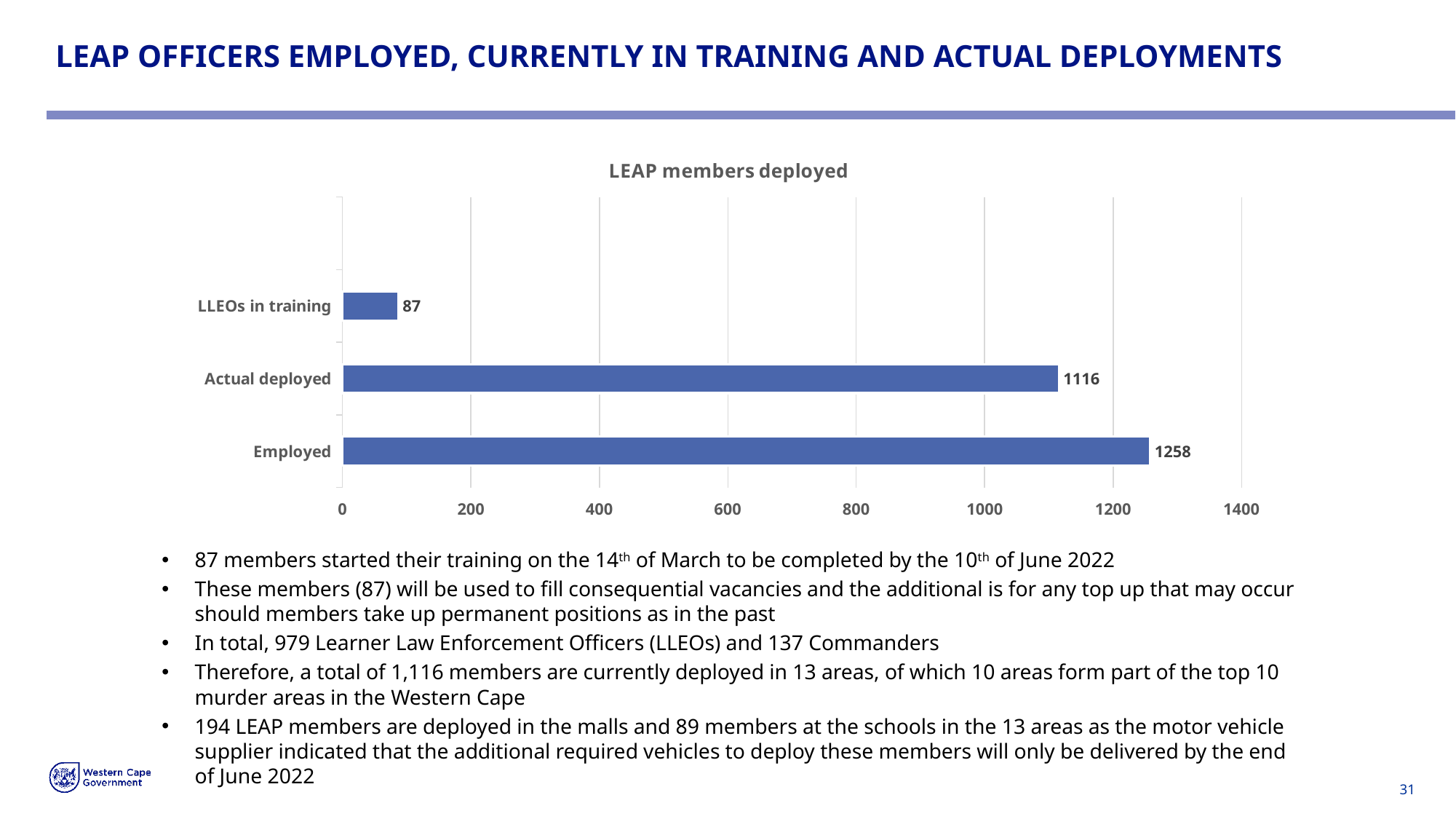
What is the value for Actual deployed? 1116 What is the difference between Actual deployed and LLEOs in training? 1029 What is the title of the chart? LEAP members deployed What is the value for Employed in the LEAP members deployed chart? 1258 Which is larger, Employed or Actual deployed? Employed Which category has the highest value? Employed How many categories are shown in the chart? 3 Is the value for Actual deployed greater or less than 1000? greater Which category has the lowest value? LLEOs in training What kind of chart is shown on the slide? Bar chart What is the value for LLEOs in training? 87 What is the difference between Employed and Actual deployed? 142